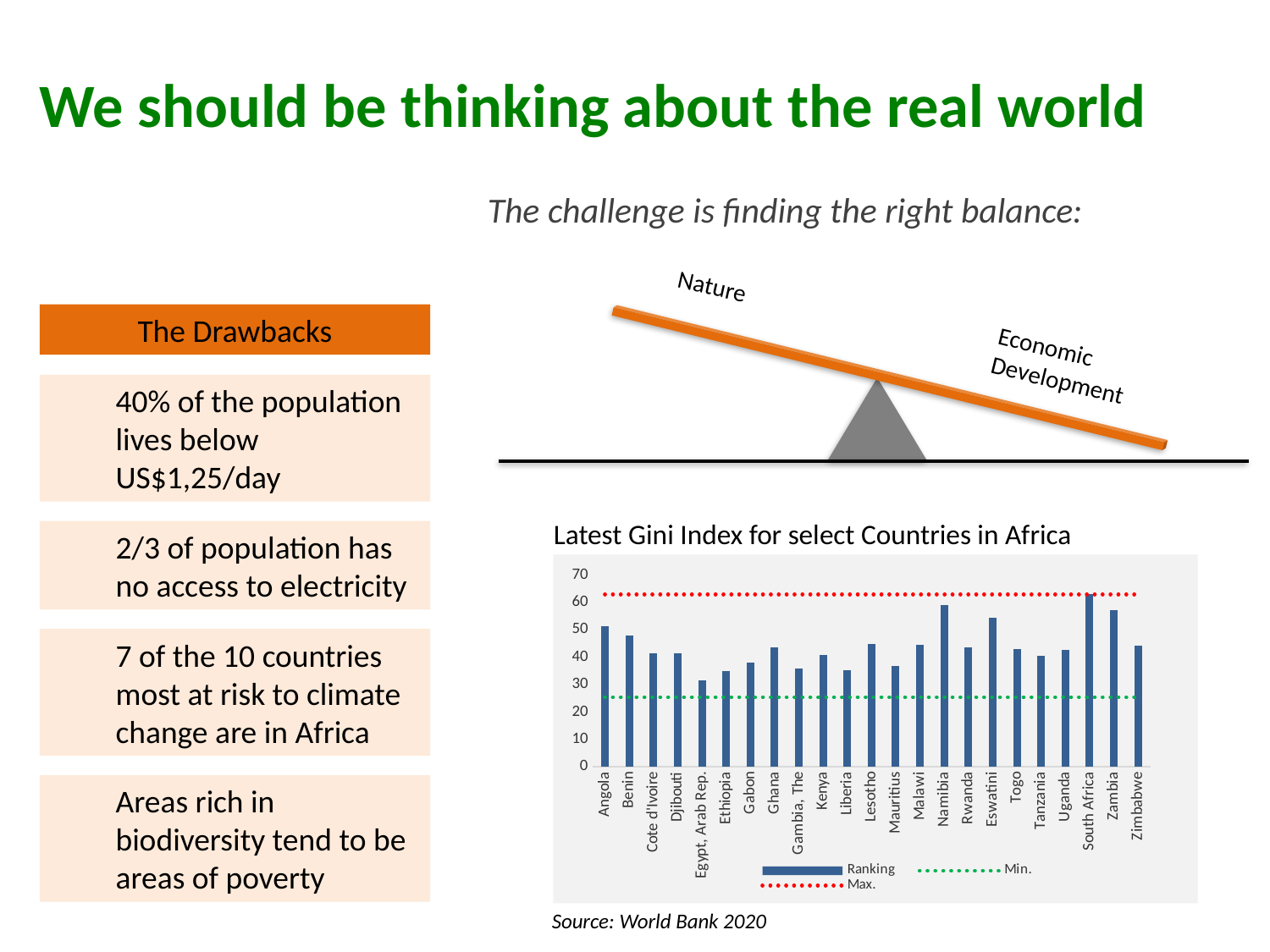
How many countries are shown on the x axis of the Gini Index chart? 23 How many series does the legend of the Gini Index chart list? 3 Which country has the lowest bar in the Gini Index chart? Egypt, Arab Rep. In the Gini Index chart, which has the larger value, Namibia or Kenya? Namibia In the Gini Index chart, is the value for Egypt, Arab Rep. greater or less than 40? less What are the three legend entries of the Gini Index chart? Ranking, Min., Max. In the Gini Index chart, which has the larger value, Ghana or Zambia? Zambia Which country has the highest bar in the Gini Index chart? South Africa What type of chart is shown under the heading 'Latest Gini Index for select Countries in Africa'? Bar chart In the Gini Index chart, is the value for Kenya greater or less than 50? less In the Gini Index chart, is the value for Zambia greater or less than 50? greater